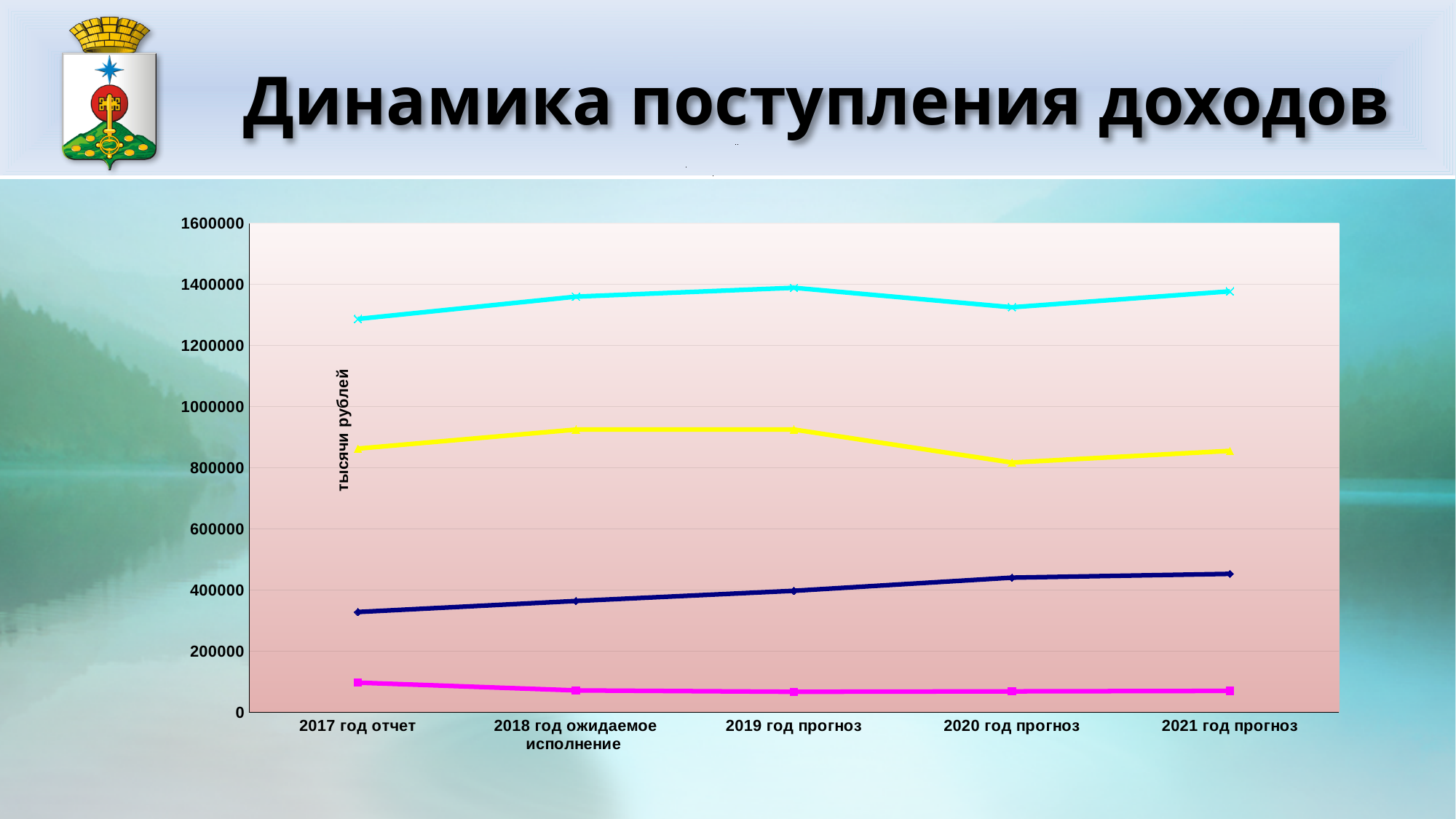
What is the title of the slide containing the chart? Динамика поступления доходов Is the value of the cyan line for 2019 год прогноз greater or less than 1200000? greater Which line has the lowest values across all categories? the magenta line Is the value of the dark blue line for 2017 год отчет greater or less than 400000? less Does the dark blue line rise or fall from 2017 год отчет to 2021 год прогноз? rise Is the value of the yellow line for 2020 год прогноз greater or less than 1000000? less How many categories are shown along the x axis of the chart? 5 What kind of chart is shown on the slide? line chart For the cyan line, which category has the lowest value? 2017 год отчет What is the label of the vertical axis of the chart? тысячи рублей Which line has the highest values across all categories: the cyan line or the yellow line? the cyan line